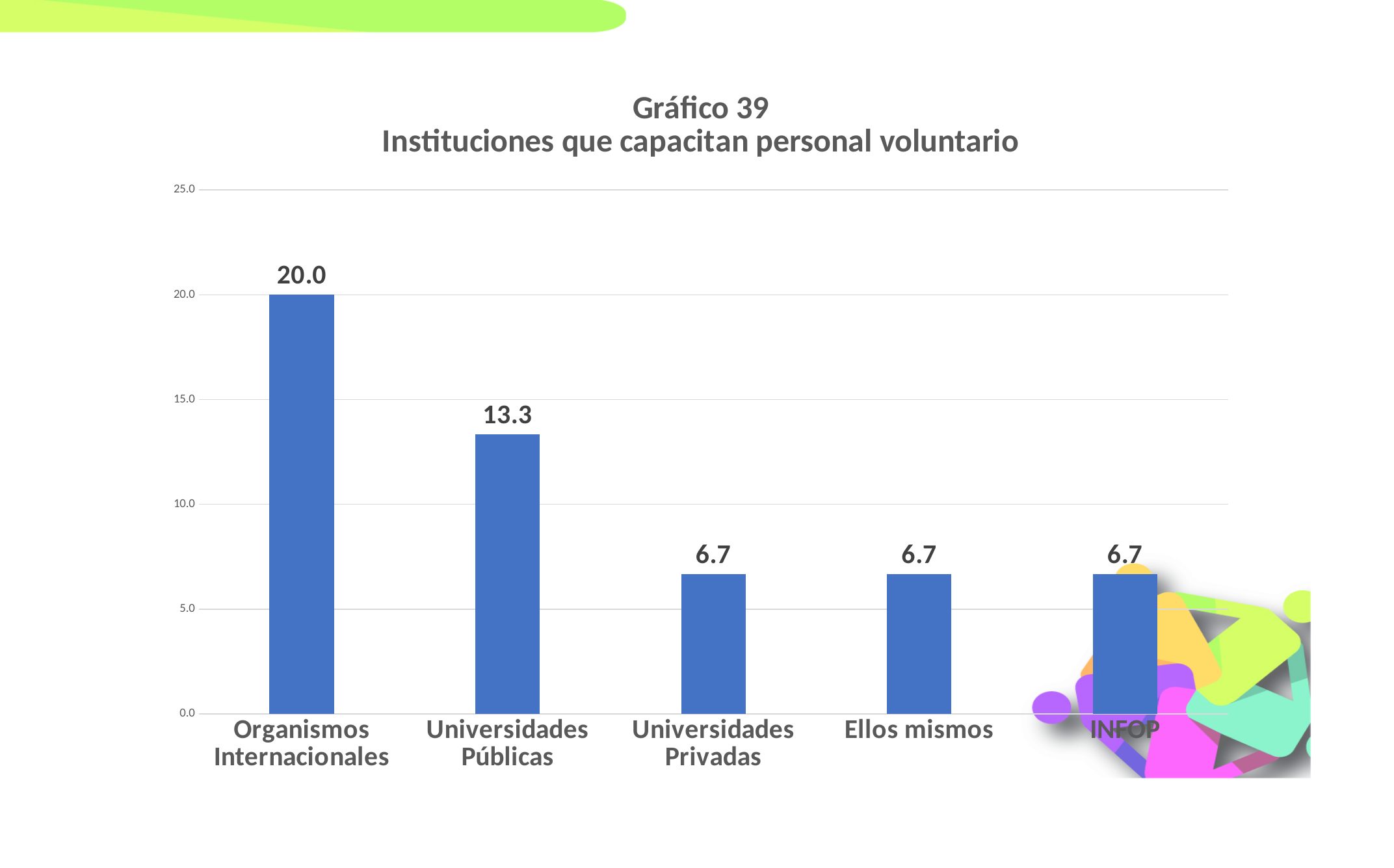
Is the value for Universidades Privadas greater or less than 10.0? less What is the value for Organismos Internacionales? 20.0 Which category has the highest value? Organismos Internacionales What is the title of the chart? Gráfico 39 Instituciones que capacitan personal voluntario What is the difference between the values for Organismos Internacionales and Universidades Públicas? 6.7 What kind of chart is shown on the slide? bar chart What is the value for INFOP? 6.7 What is the difference between the values for Universidades Públicas and Universidades Privadas? 6.6 What is the value for Universidades Públicas? 13.3 How many categories are shown on the x axis? 5 Which is larger, the value for Universidades Públicas or the value for Ellos mismos? Universidades Públicas What is the value for Ellos mismos? 6.7